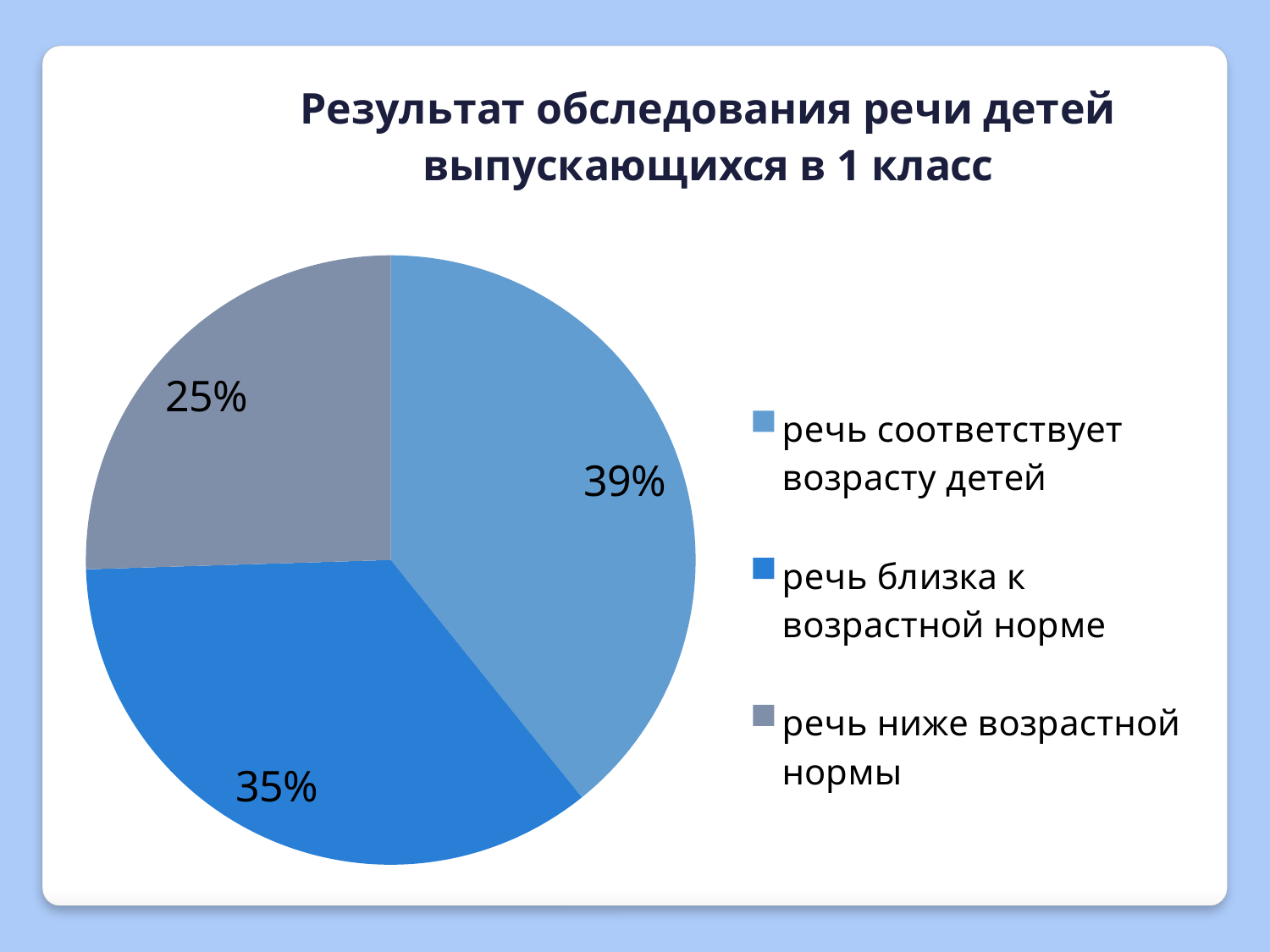
Which category is shown in grey in the legend? речь ниже возрастной нормы What share of the pie does "речь соответствует возрасту детей" have? 39% What is the difference in percentage points between "речь близка к возрастной норме" and "речь ниже возрастной нормы"? 10% Which is larger: the slice for "речь близка к возрастной норме" or the slice for "речь ниже возрастной нормы"? речь близка к возрастной норме What is the title of the chart? Результат обследования речи детей выпускающихся в 1 класс What share of the pie does "речь ниже возрастной нормы" have? 25% Which category has the largest slice of the pie? речь соответствует возрасту детей What is the difference in percentage points between "речь соответствует возрасту детей" and "речь ниже возрастной нормы"? 14% What share of the pie does "речь близка к возрастной норме" have? 35% How many slices does the pie chart have? 3 Which category has the smallest slice of the pie? речь ниже возрастной нормы What kind of chart is shown on the slide? pie chart